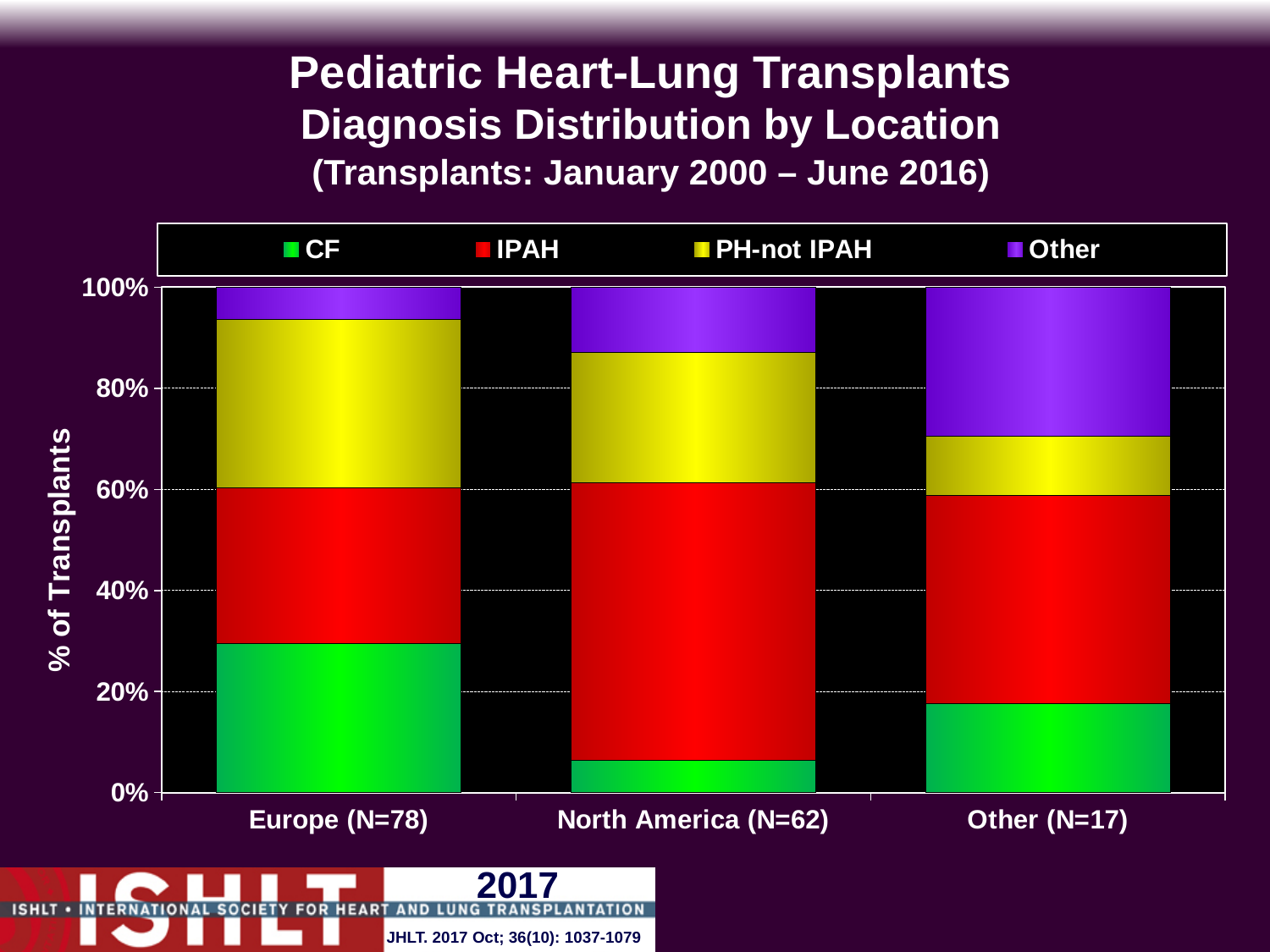
Is the CF share for North America (N=62) greater or less than 20%? less What kind of chart is shown on the slide? Stacked bar chart How many location categories are shown on the x axis? 3 Is the IPAH share for North America (N=62) greater or less than 40%? greater What is the N value shown for Europe on the x axis? 78 Is the Other diagnosis share for Other (N=17) greater or less than 20%? greater Which location has the largest IPAH share of transplants? North America (N=62) Which location has the largest CF share of transplants? Europe (N=78) Which location has the smallest CF share of transplants? North America (N=62) How many series does the legend list? 4 Is the Other diagnosis share larger for Europe (N=78) or for Other (N=17)? Other (N=17)